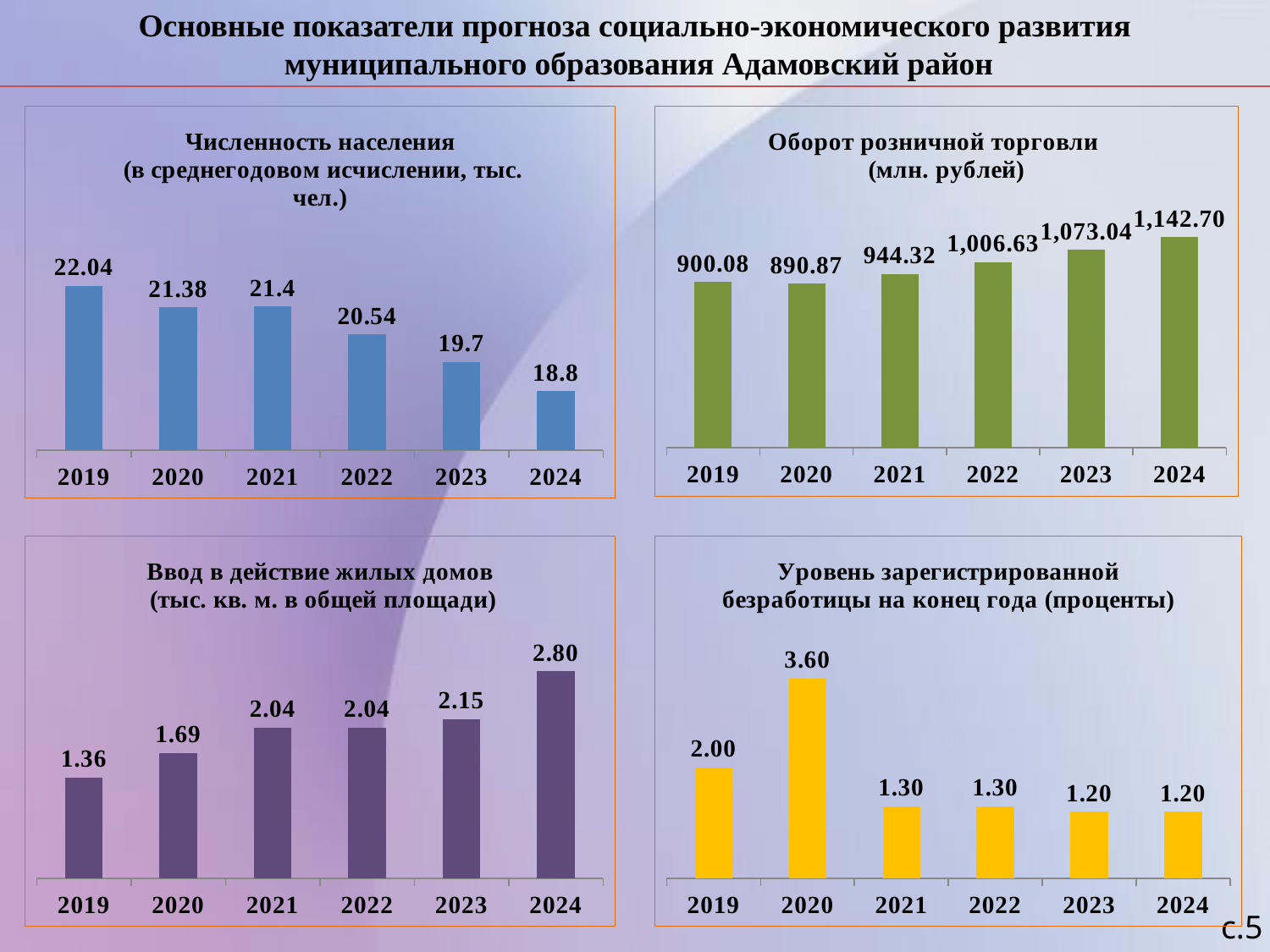
In the top-right chart (Оборот розничной торговли), which year has the highest value? 2024 What type of chart is the bottom-right chart (Уровень зарегистрированной безработицы)? bar chart In the top-right chart (Оборот розничной торговли), what is the value for 2023? 1,073.04 In the top-left chart (Численность населения), what is the value for 2022? 20.54 How many years are shown on the x axis of the bottom-left chart (Ввод в действие жилых домов)? 6 In the bottom-right chart (Уровень зарегистрированной безработицы), what is the value for 2024? 1.20 In the bottom-right chart (Уровень зарегистрированной безработицы), which year has the highest value? 2020 In the bottom-left chart (Ввод в действие жилых домов), what is the value for 2020? 1.69 In the top-left chart (Численность населения), do the values rise or fall from 2019 to 2024? fall In the bottom-left chart (Ввод в действие жилых домов), what is the difference between the 2024 and 2019 values? 1.44 In the top-left chart (Численность населения), which year has the lowest value? 2024 In the top-right chart (Оборот розничной торговли), which is larger, the value for 2019 or 2020? 2019